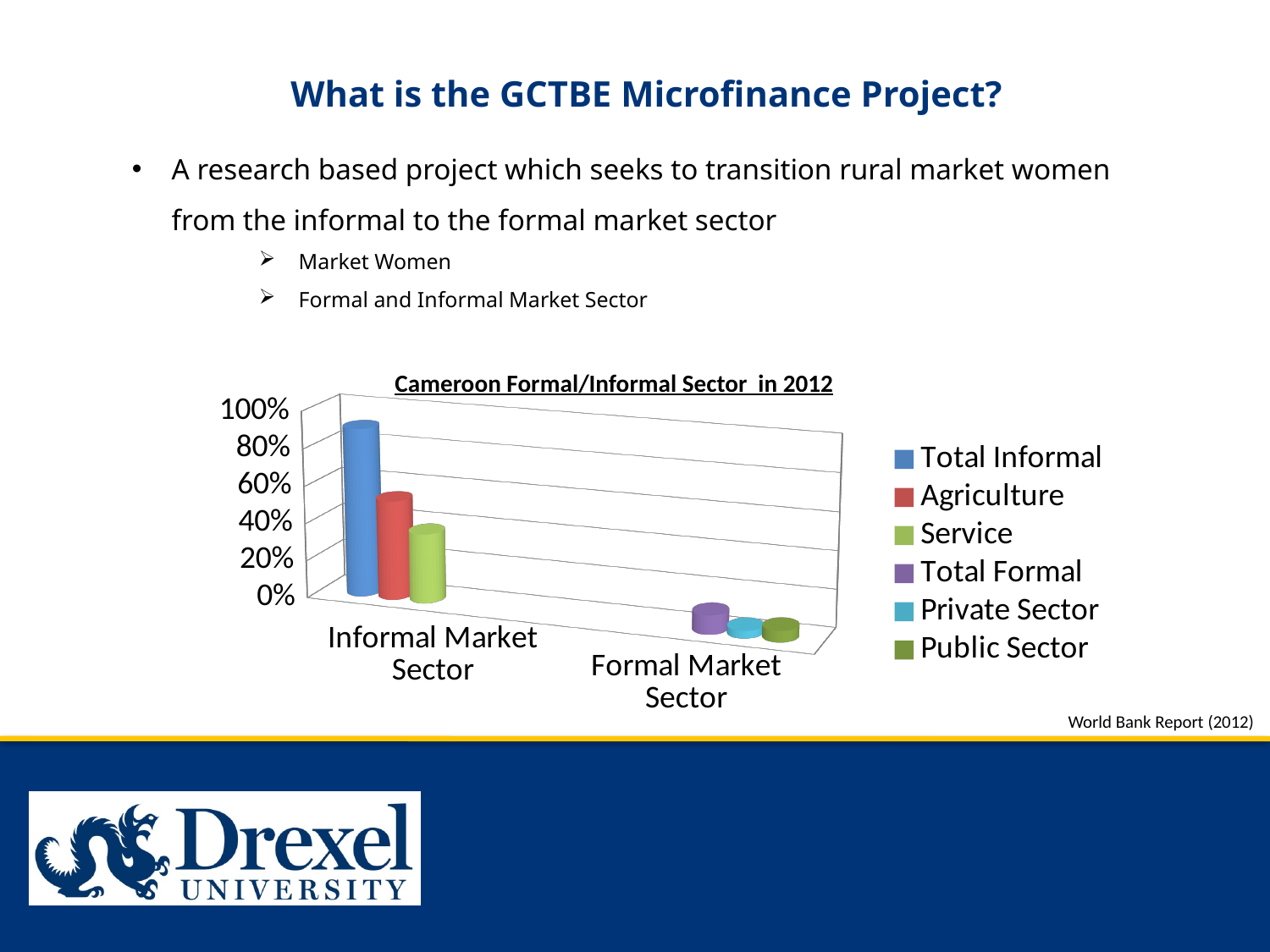
Which series has the highest value in the chart? Total Informal What kind of chart is shown on the slide? bar chart How many series does the chart legend list? 6 Is the value for Total Formal greater or less than 40%? less Which is larger, the value for Agriculture or the value for Service? Agriculture Which colour represents the Service series in the legend? green Is the value for Total Informal greater or less than 60%? greater What is the title of the chart? Cameroon Formal/Informal Sector in 2012 Which is larger, the value for Total Informal or the value for Agriculture? Total Informal How many categories are shown on the x axis of the chart? 2 Is the value for Service greater or less than 60%? less